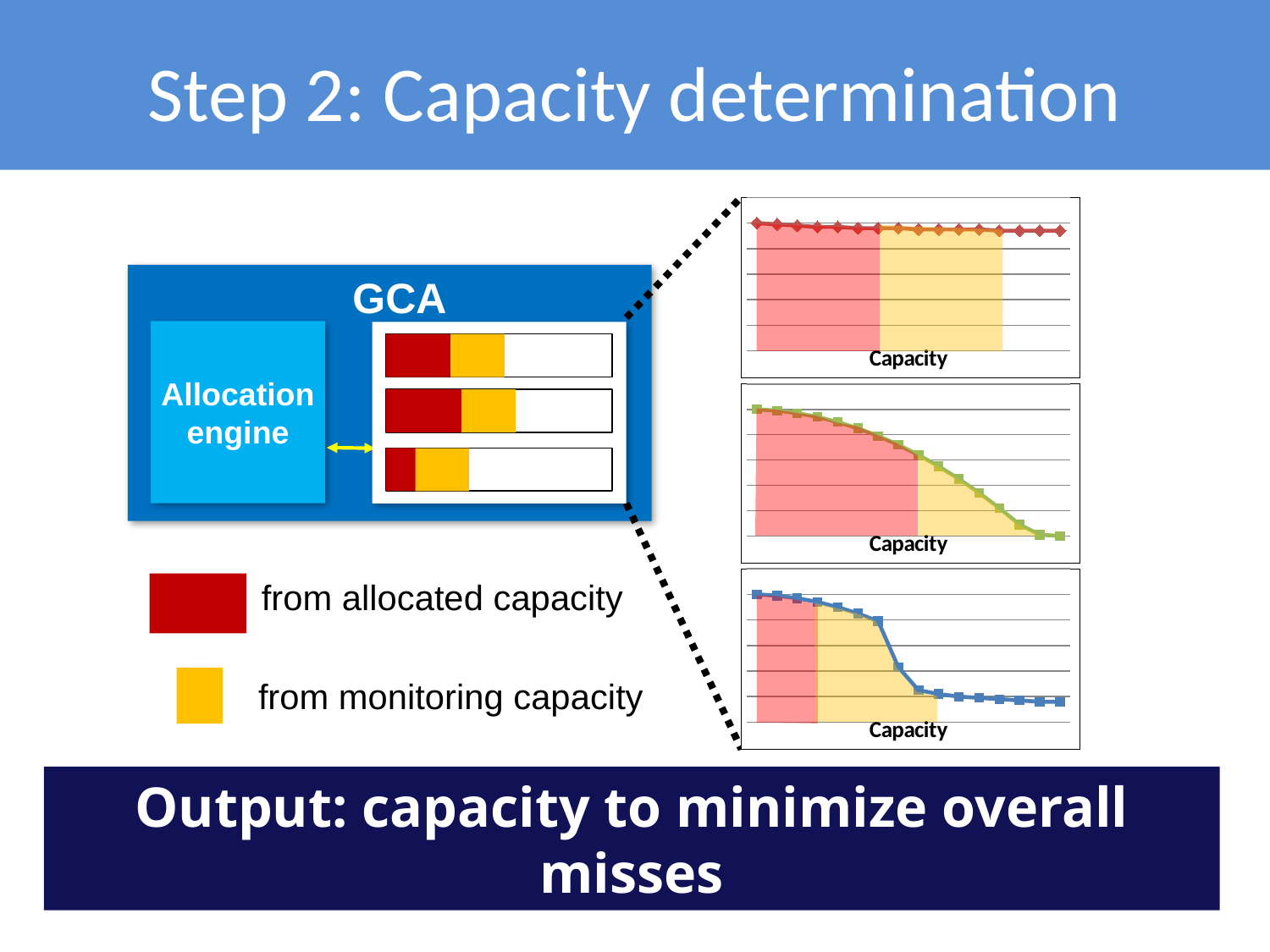
What kind of chart is the middle chart on the right side of the slide? line chart In the top chart on the right, do the values rise, fall, or stay roughly flat along the x axis? stay roughly flat What kind of chart is the top chart on the right side of the slide? line chart Which of the three charts on the right shows the steepest drop in the middle of the x axis? the bottom chart What kind of chart is the bottom chart on the right side of the slide? line chart In the middle chart on the right, do the values rise or fall as capacity increases along the x axis? fall How many line charts are shown on the right side of the slide? 3 What is the x-axis label of the top chart on the right? Capacity In the bottom chart on the right, do the values rise or fall as capacity increases along the x axis? fall What colour is the line in the bottom chart on the right? blue